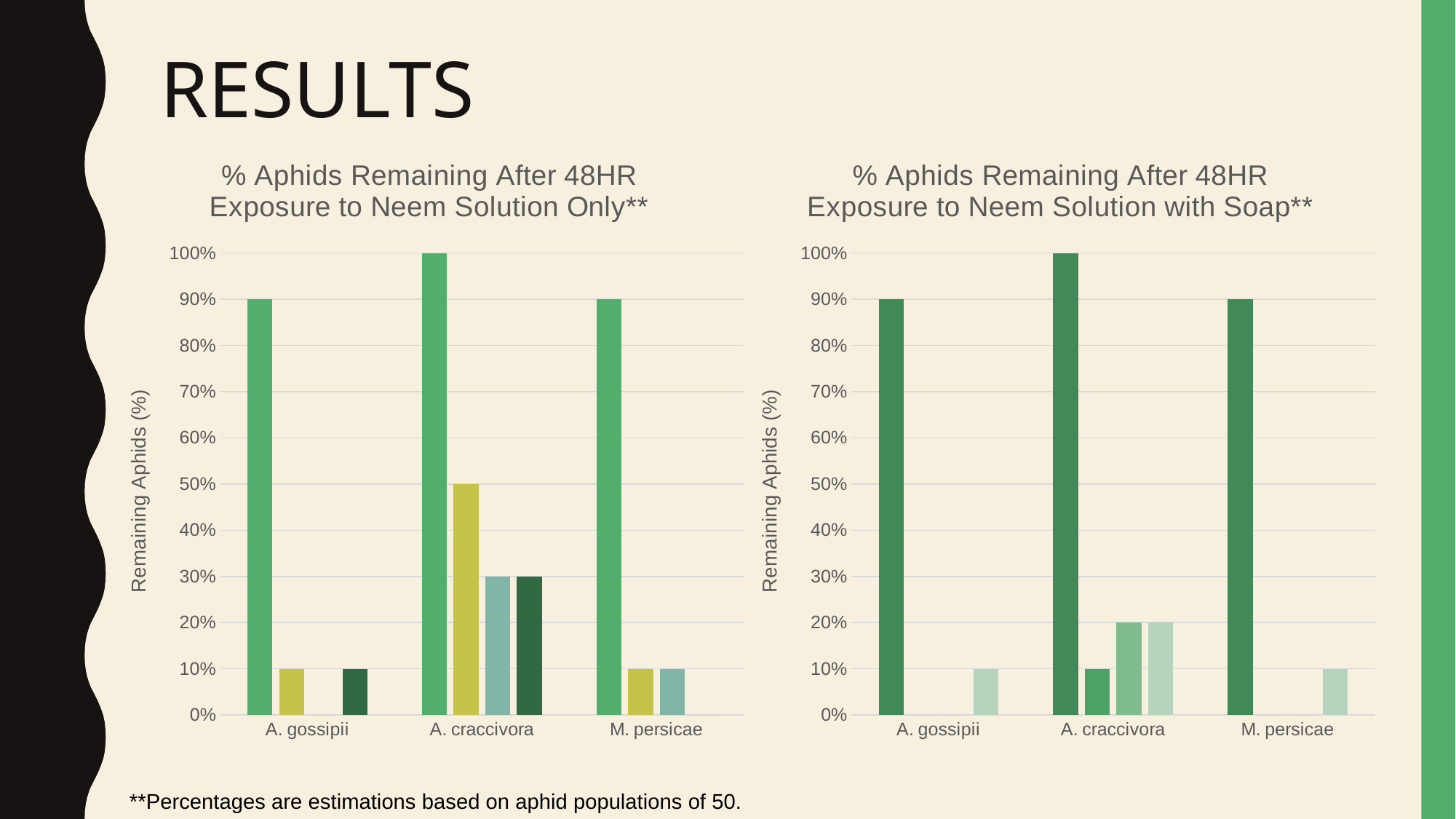
What is the y-axis label on the left chart? Remaining Aphids (%) What kind of chart is the left chart, '% Aphids Remaining After 48HR Exposure to Neem Solution Only**'? Bar chart In the left chart (Neem Solution Only), is the tallest bar for M. persicae greater or less than 80%? greater In the right chart (Neem Solution with Soap), which category has the tallest bar? A. craccivora In the right chart (Neem Solution with Soap), what value does the tallest bar for M. persicae reach? 90% In the right chart (Neem Solution with Soap), is the tallest bar for A. gossipii greater or less than 100%? less In the left chart (Neem Solution Only), what value does the tallest bar for A. gossipii reach? 90% In the right chart (Neem Solution with Soap), which is taller: the tallest bar for A. craccivora or the tallest bar for A. gossipii? A. craccivora In the left chart (Neem Solution Only), which category has the tallest bar? A. craccivora In the left chart (Neem Solution Only), what value does the second (yellow) bar for A. craccivora reach? 50% In the left chart (Neem Solution Only), what value does the tallest bar for A. craccivora reach? 100% How many aphid species categories are shown on the x axis of the right chart, '% Aphids Remaining After 48HR Exposure to Neem Solution with Soap**'? 3